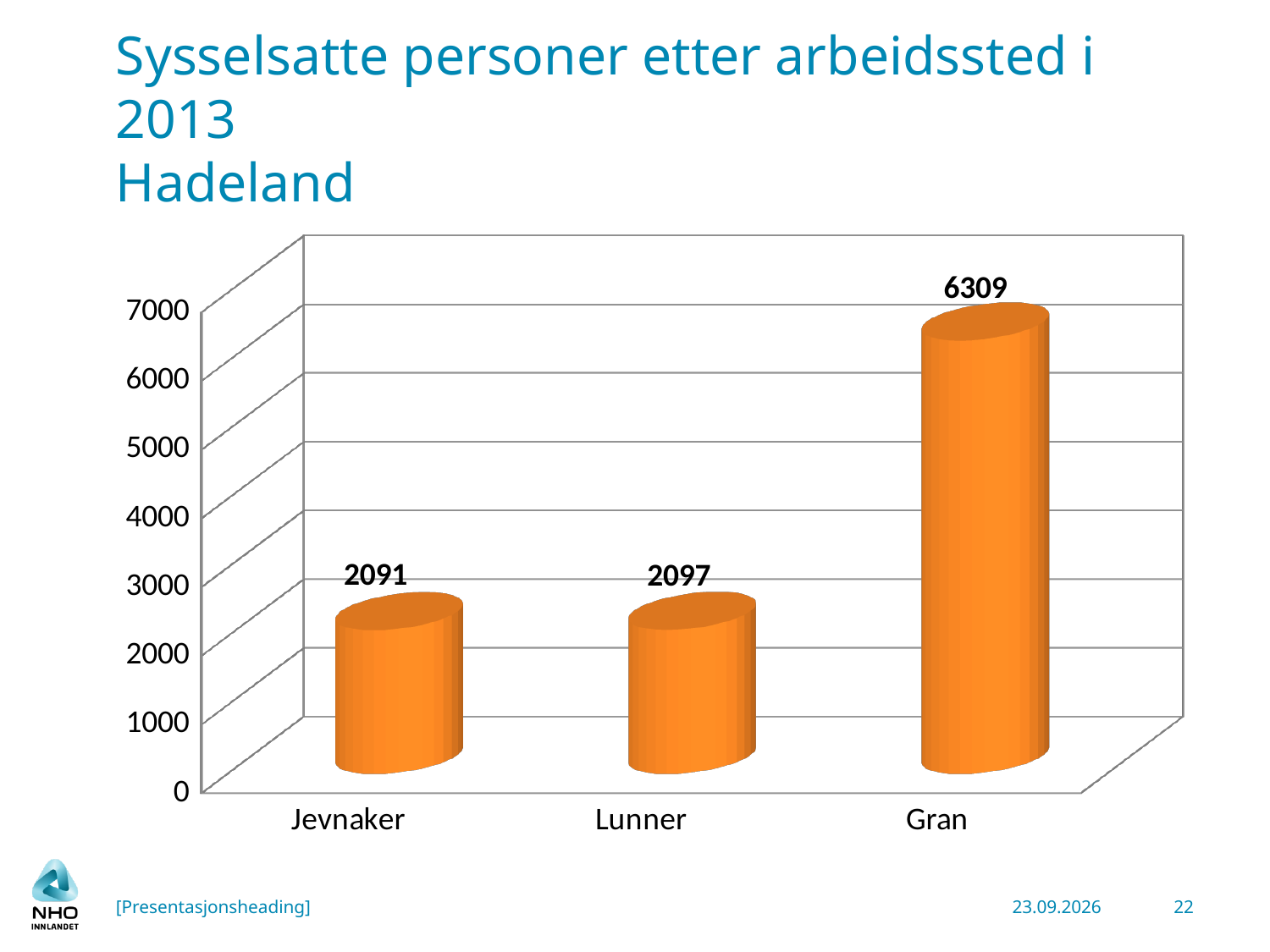
What is the title of the slide? Sysselsatte personer etter arbeidssted i 2013 Hadeland Which category has the highest value? Gran Is the value for Gran greater or less than 6000? greater What is the difference between the values for Gran and Lunner? 4212 What is the value for Gran? 6309 What is the difference between the values for Gran and Jevnaker? 4218 Which is larger, the value for Gran or the value for Lunner? Gran How many categories are shown on the x axis? 3 What is the value for Jevnaker? 2091 What kind of chart is shown on the slide? Bar chart Is the value for Jevnaker greater or less than 3000? less What is the value for Lunner? 2097